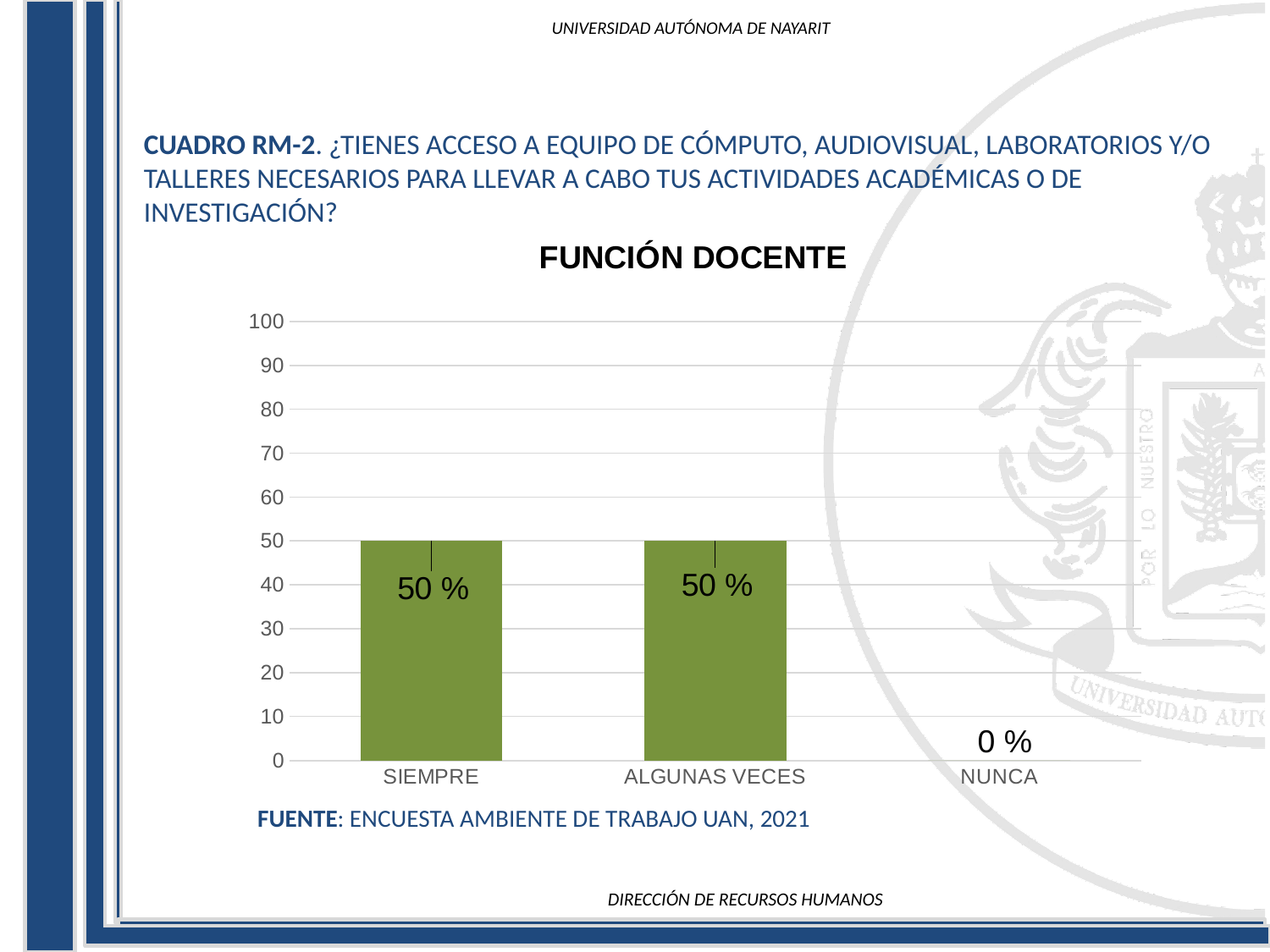
What is the value for SIEMPRE? 50 % What is the value for ALGUNAS VECES? 50 % What is the value for NUNCA? 0 % Which category has the lowest value? NUNCA How many categories are shown on the x axis? 3 What is the difference between the values for SIEMPRE and NUNCA? 50 % What is the total of the values for SIEMPRE and ALGUNAS VECES? 100 % Is the value for SIEMPRE greater or less than 60? less Which is larger, the value for ALGUNAS VECES or the value for NUNCA? ALGUNAS VECES What is the highest value shown on the y axis? 100 What is the title of the chart? FUNCIÓN DOCENTE What kind of chart is shown on the slide? bar chart